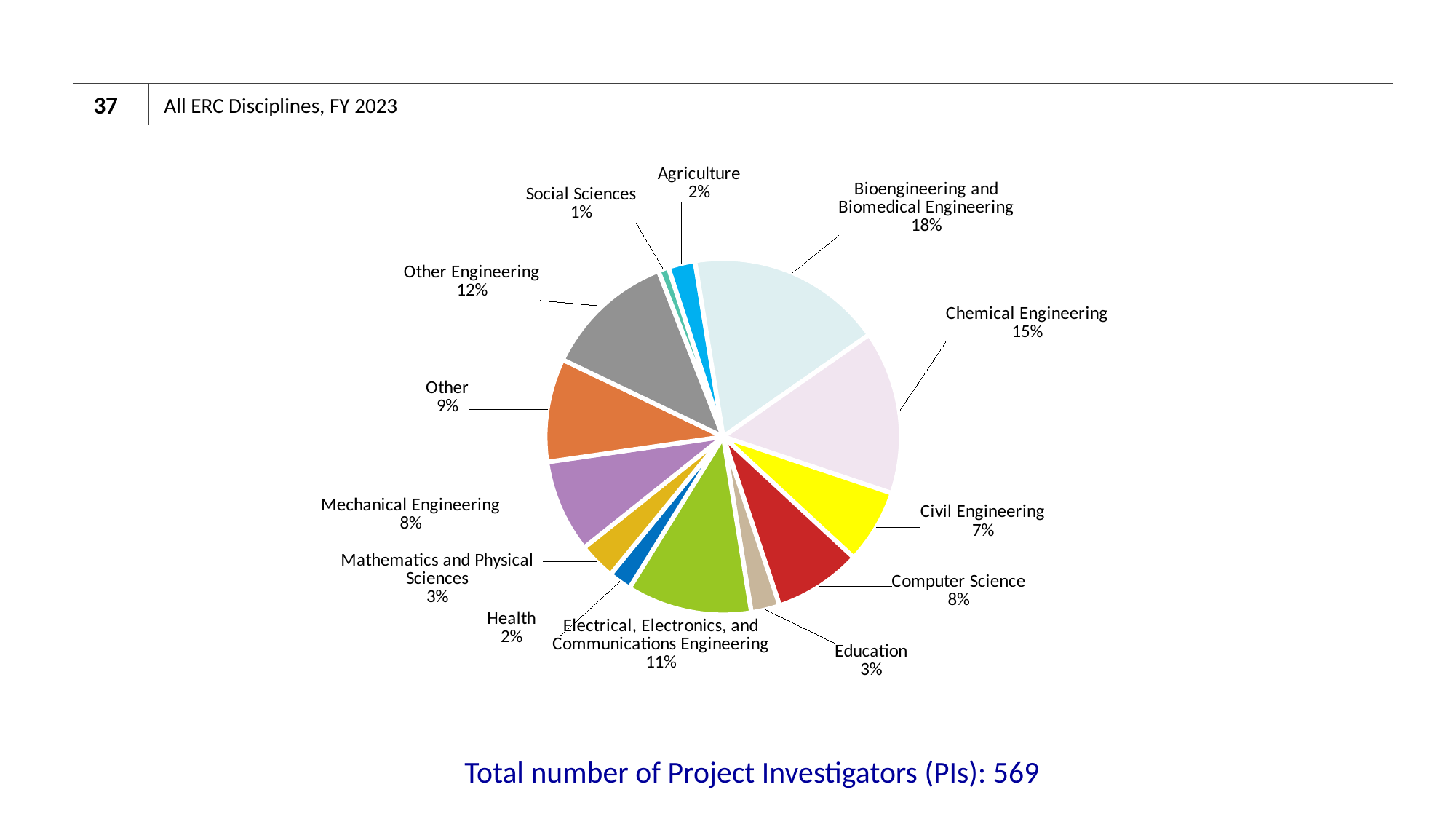
What percentage is shown for Chemical Engineering? 15% What percentage is shown for Other Engineering? 12% What is the title of the slide containing the chart? All ERC Disciplines, FY 2023 What share of the pie does Bioengineering and Biomedical Engineering represent? 18% Which discipline has the largest slice of the pie? Bioengineering and Biomedical Engineering What type of chart is shown on the slide? Pie chart Which discipline has the smallest slice of the pie? Social Sciences What percentage is shown for Electrical, Electronics, and Communications Engineering? 11% What total number of Project Investigators (PIs) is stated below the chart? 569 Which is larger, the share for Other Engineering or the share for Other? Other Engineering How many disciplines (slices) are shown in the pie chart? 13 What is the difference in percentage points between Chemical Engineering and Civil Engineering? 8